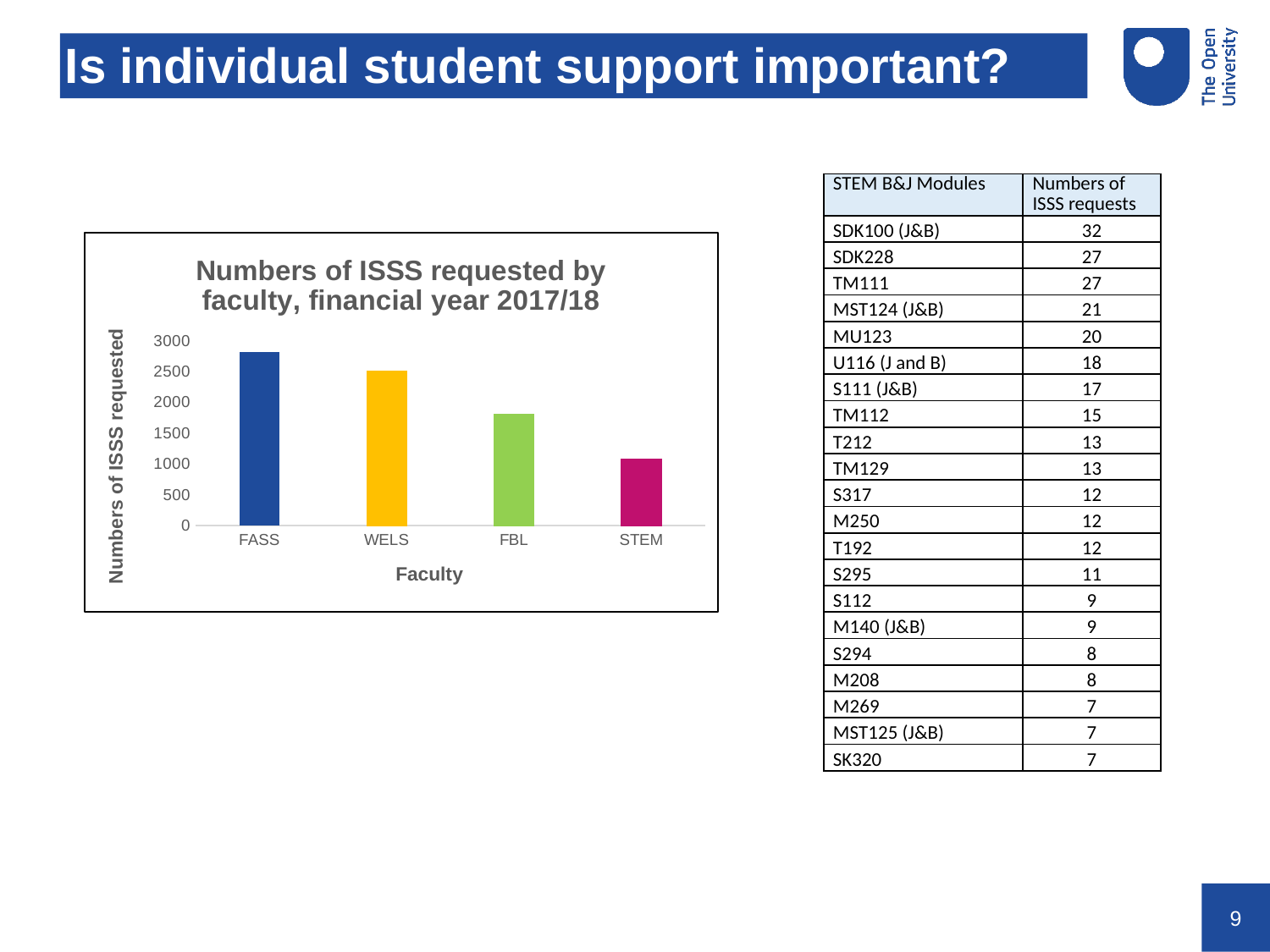
What is the label on the x axis of the chart? Faculty Which faculty has the lowest number of ISSS requested? STEM Which faculty has the highest number of ISSS requested? FASS Which faculty has more ISSS requested, STEM or FBL? FBL How many faculties are shown on the x axis of the chart? 4 Do the bar values rise or fall from left to right across the faculties? fall Is the value for FASS greater or less than 2500? greater Which faculty has more ISSS requested, WELS or FBL? WELS Is the value for FBL greater or less than 1500? greater Is the value for STEM greater or less than 1500? less What is the title of the chart? Numbers of ISSS requested by faculty, financial year 2017/18 What kind of chart is shown on the slide? bar chart